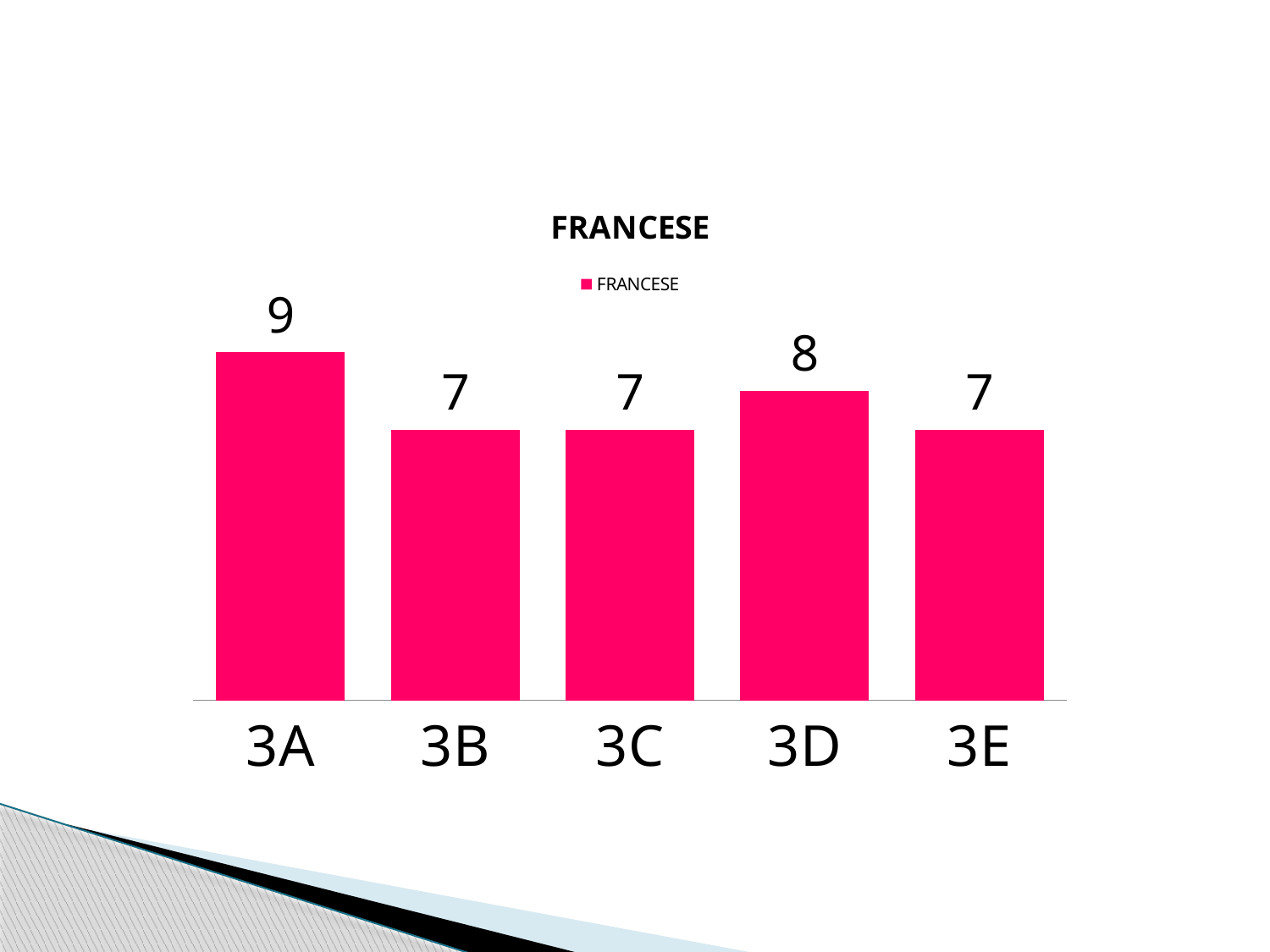
What is the value for 3D? 8 What is the difference between the values for 3A and 3C? 2 Which category has the highest value? 3A What is the difference between the values for 3A and 3D? 1 What is the value for 3E? 7 How many categories are shown on the x axis? 5 What kind of chart is this? bar chart What is the value for 3A? 9 What is the title of the chart? FRANCESE What is the value for 3B? 7 How many series does the legend list? 1 Which is larger, the value for 3D or the value for 3E? 3D